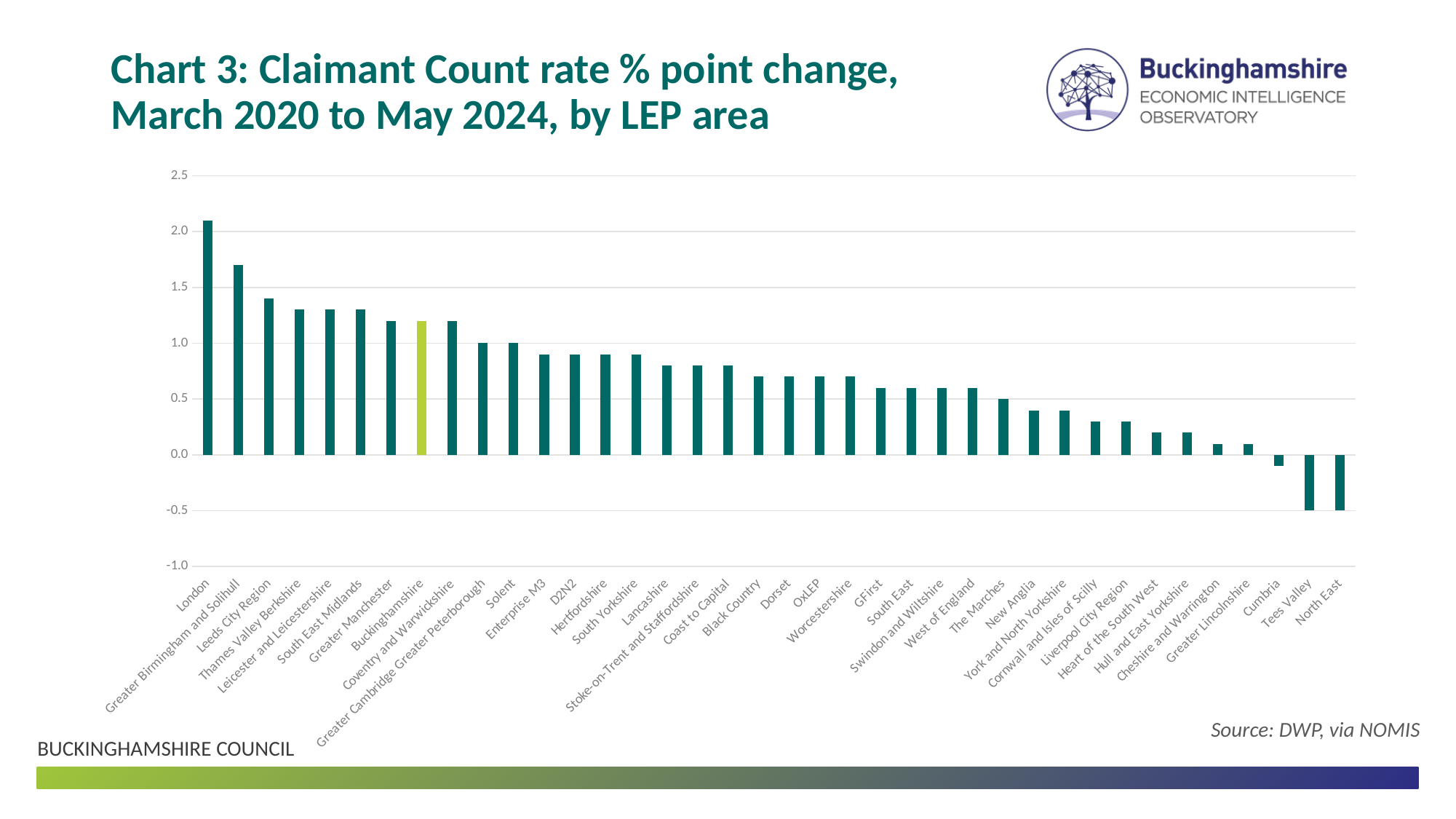
Which LEP area's bar is highlighted in a different (light green) colour from the others? Buckinghamshire Do the values generally rise or fall moving from left to right along the x axis? Fall What is the Claimant Count rate % point change for The Marches? 0.5 What is the Claimant Count rate % point change for Solent? 1.0 Is the value for Buckinghamshire greater or less than 1.0? greater Is the value for London greater or less than 2.0? greater What is the Claimant Count rate % point change for Tees Valley? -0.5 Which has the larger value, London or Greater Birmingham and Solihull? London Is the value for Cumbria greater or less than 0.0? less Which LEP area has the highest Claimant Count rate % point change? London What kind of chart is shown on the slide? Bar chart How many LEP areas are plotted on the chart? 38